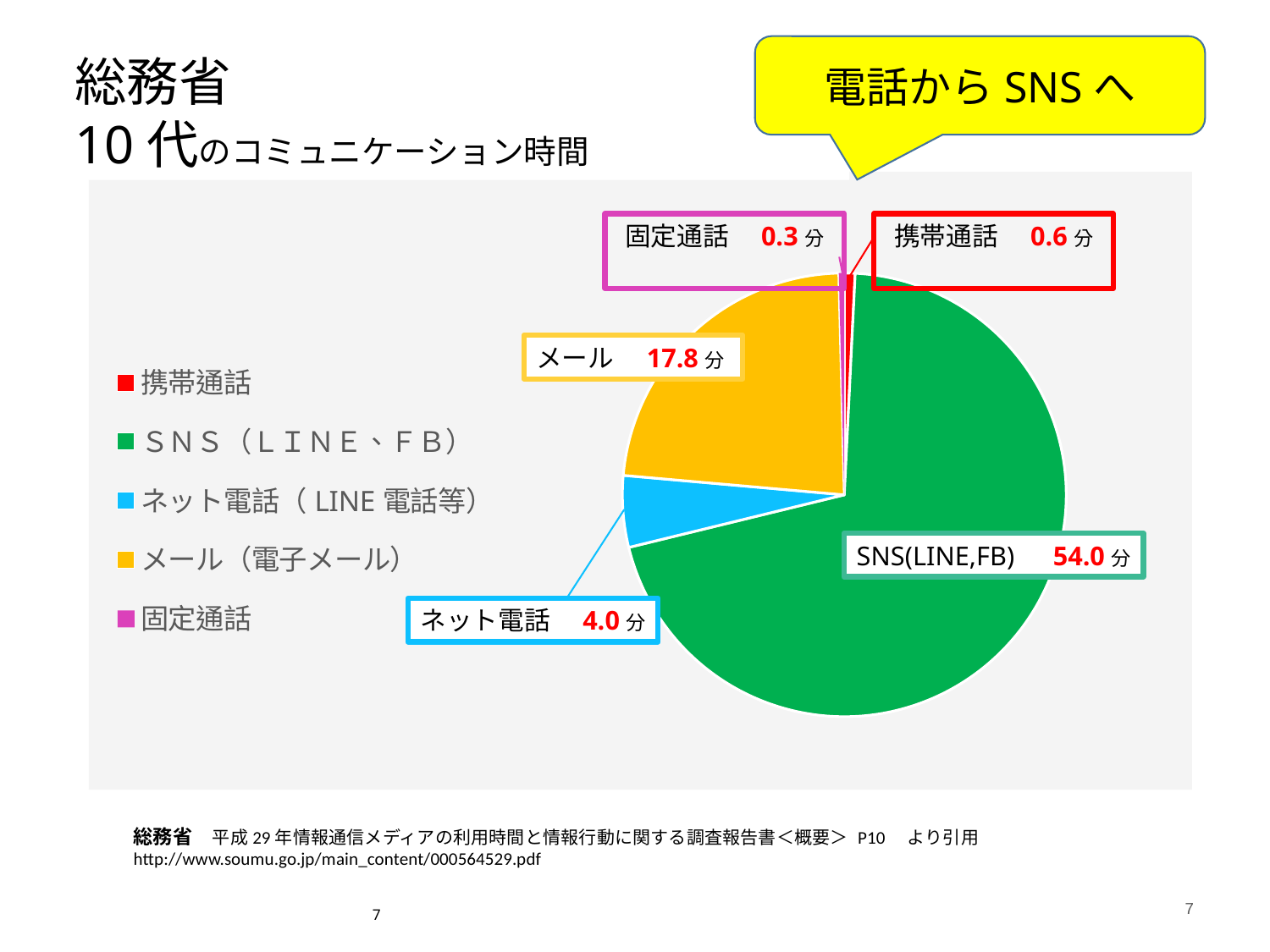
Which category has the largest slice of the pie? SNS(LINE,FB) What is the value shown for SNS(LINE,FB)? 54.0分 Which category has the smallest value? 固定通話 What is the value shown for 固定通話? 0.3分 What colour is the SNS（LINE、FB） slice in the pie chart? green What is the value shown for メール? 17.8分 What is the difference between the values for SNS(LINE,FB) and メール? 36.2分 What is the value shown for 携帯通話? 0.6分 What is the value shown for ネット電話? 4.0分 What kind of chart is shown on the slide? pie chart How many categories does the pie chart have? 5 Which is larger, the value for メール or the value for ネット電話? メール